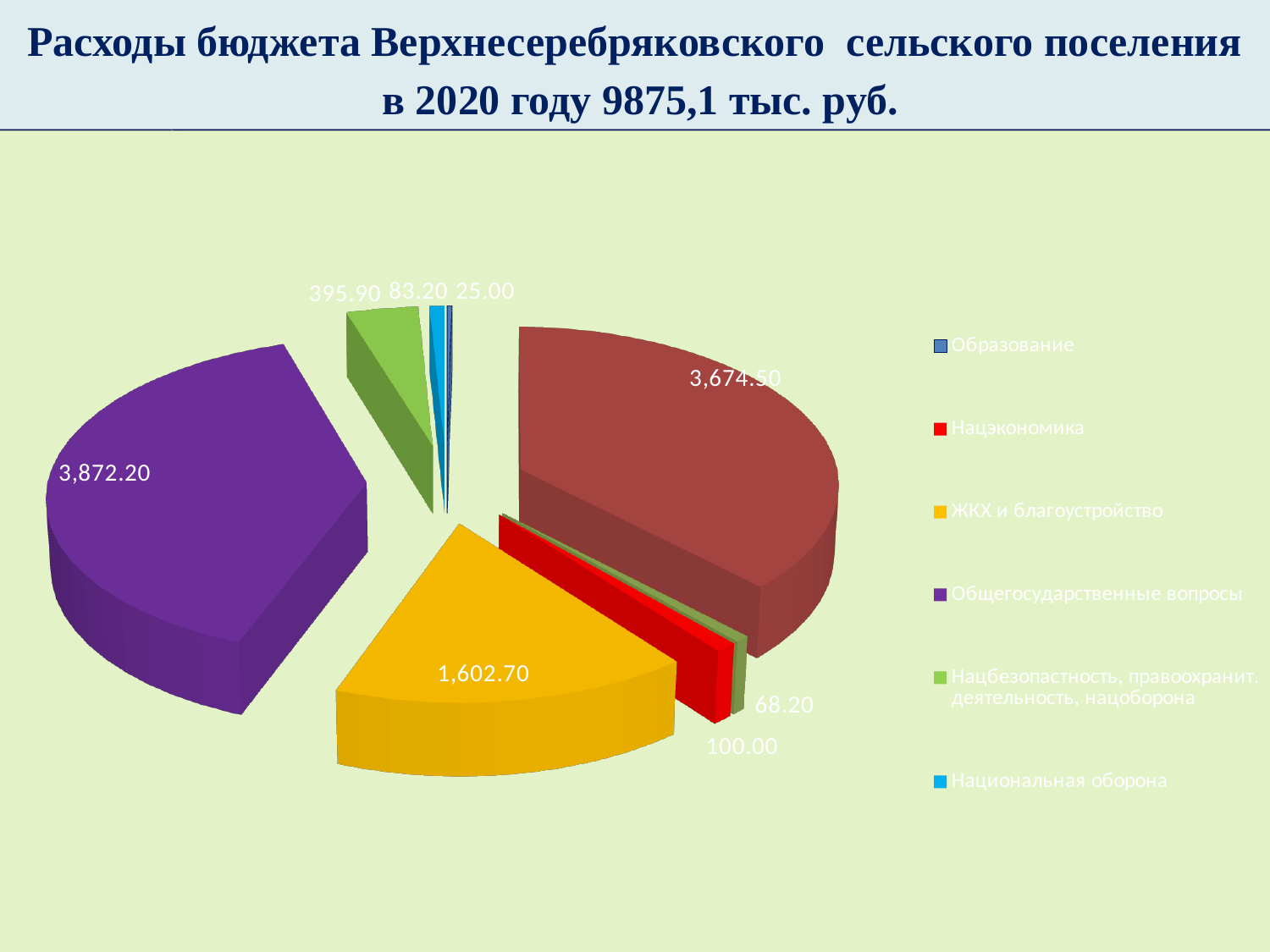
What value is shown for the ЖКХ и благоустройство slice? 1,602.70 What value is shown for the Нацэкономика slice? 100.00 What value is shown for the Национальная оборона slice? 83.20 What type of chart is shown on the slide? Pie chart Which legend category has the smallest slice in the pie chart? Образование What is the difference between the largest slice (3,872.20) and the second largest slice (3,674.50)? 197.70 Which is larger: the ЖКХ и благоустройство slice or the Нацэкономика slice? ЖКХ и благоустройство What value is shown for the Образование slice? 25.00 Which legend category has the largest slice in the pie chart? Общегосударственные вопросы How many entries does the legend list? 6 How many slices does the pie chart have? 8 What value is shown for the Общегосударственные вопросы slice? 3,872.20